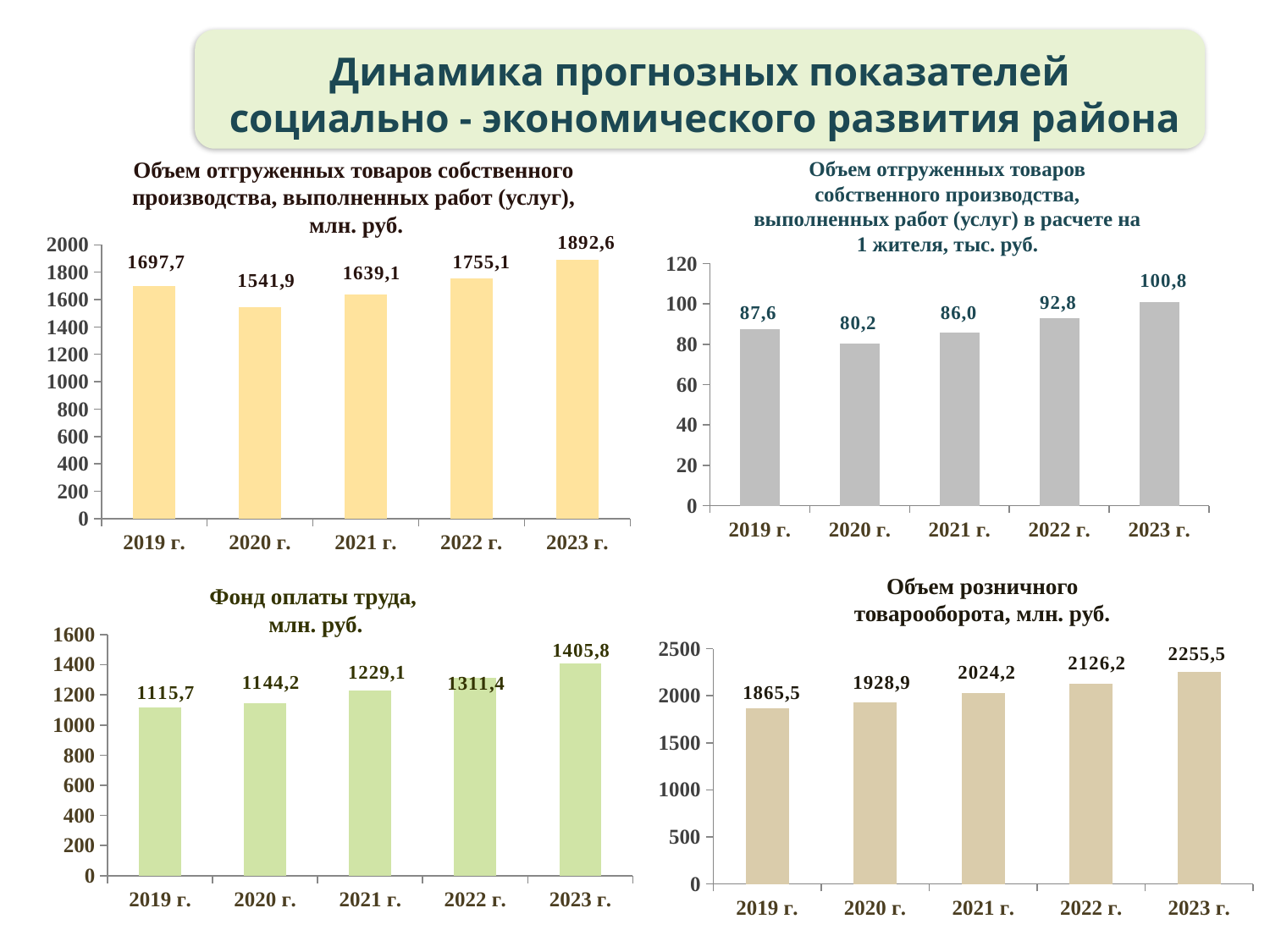
In the top-left chart (Объем отгруженных товаров собственного производства, млн. руб.), what is the value for 2021 г.? 1639,1 In the top-left chart (Объем отгруженных товаров собственного производства, млн. руб.), what is the difference between the 2023 г. and 2020 г. values? 350,7 How many charts are shown on the slide, and what type of chart are they? 4 bar charts In the bottom-left chart (Фонд оплаты труда, млн. руб.), what is the difference between the 2023 г. and 2019 г. values? 290,1 In the bottom-left chart (Фонд оплаты труда, млн. руб.), do the values rise or fall from 2019 г. to 2023 г.? rise In the top-right chart (в расчете на 1 жителя, тыс. руб.), what is the value for 2022 г.? 92,8 In the top-right chart (в расчете на 1 жителя, тыс. руб.), what is the difference between the 2023 г. and 2020 г. values? 20,6 In the top-left chart (Объем отгруженных товаров собственного производства, млн. руб.), which year has the lowest value? 2020 г. In the bottom-right chart (Объем розничного товарооборота, млн. руб.), is the value for 2023 г. greater or less than 2000? greater In the bottom-right chart (Объем розничного товарооборота, млн. руб.), what is the value for 2021 г.? 2024,2 In the top-right chart (в расчете на 1 жителя, тыс. руб.), which year has the highest value? 2023 г. In the bottom-left chart (Фонд оплаты труда, млн. руб.), what is the value for 2019 г.? 1115,7